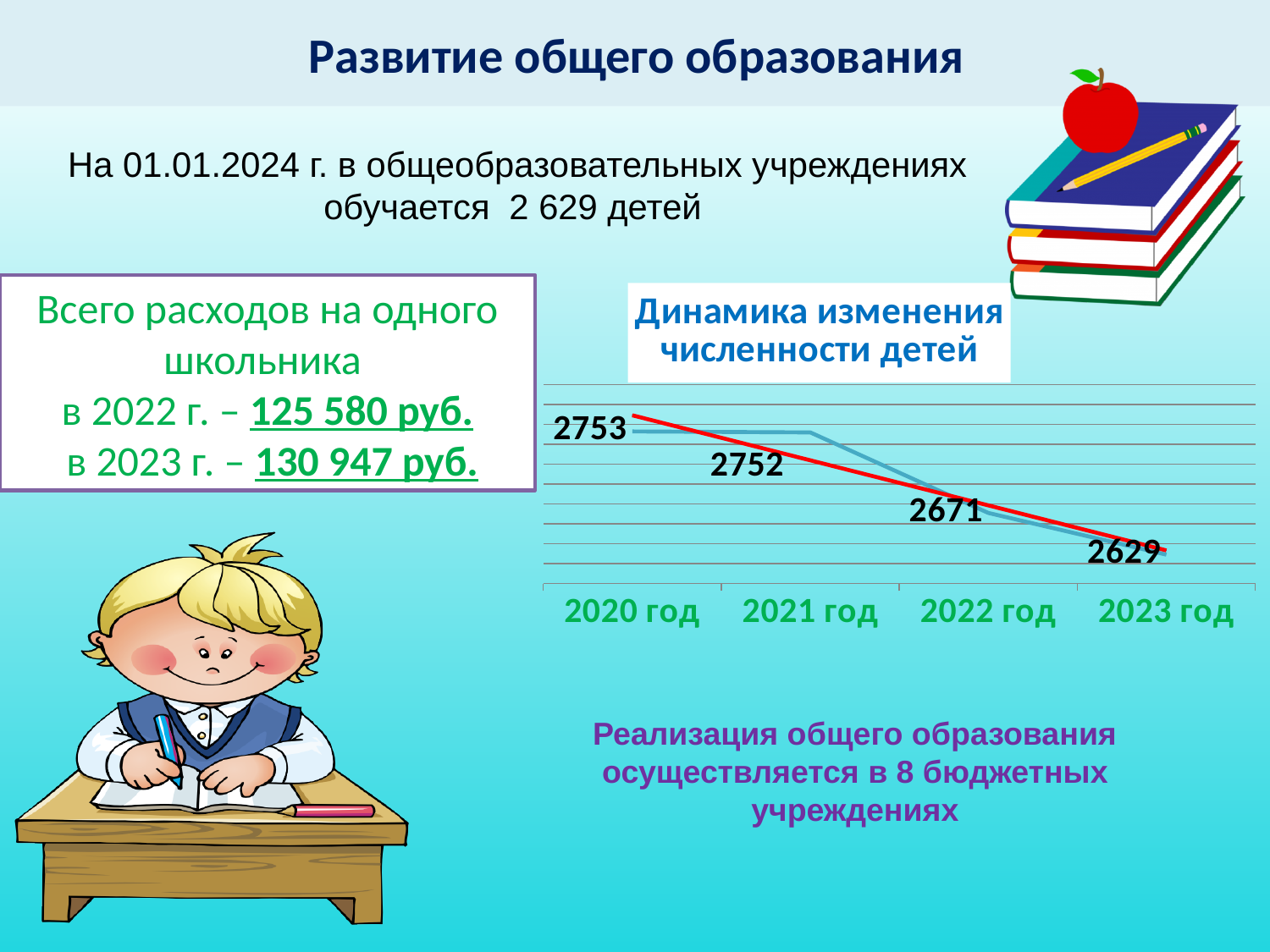
What is the number of children shown for 2022 год in the chart? 2671 Which year has the highest number of children in the chart? 2020 год Do the values in the chart rise or fall from 2020 год to 2023 год? fall What is the number of children shown for 2021 год in the chart? 2752 What is the number of children shown for 2023 год in the chart? 2629 What is the number of children shown for 2020 год in the chart? 2753 How many years are plotted on the x axis of the chart? 4 What is the difference between the number of children in 2022 год and 2023 год? 42 What is the difference between the number of children in 2021 год and 2022 год? 81 What kind of chart is used to show the dynamics of the number of children? line chart Which is larger: the number of children in 2020 год or in 2022 год? 2020 год Which year has the lowest number of children in the chart? 2023 год